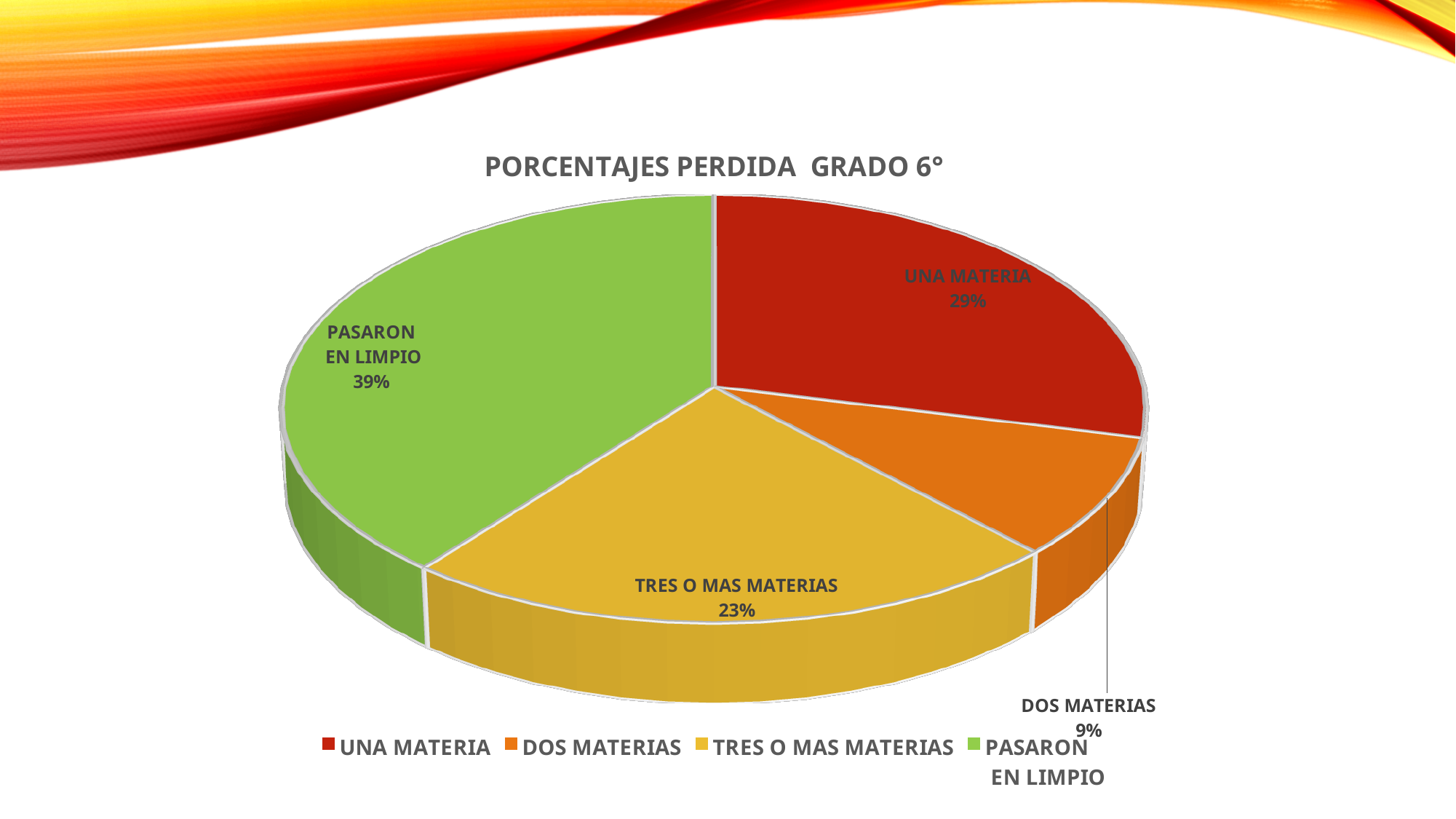
How many categories does the pie chart show? 4 What colour is the slice for PASARON EN LIMPIO? Green Which category has the largest share of the pie? PASARON EN LIMPIO What percentage is shown for PASARON EN LIMPIO? 39% What is the title of the chart? PORCENTAJES PERDIDA GRADO 6° What percentage is shown for UNA MATERIA? 29% What kind of chart is shown on the slide? Pie chart What is the difference in percentage points between PASARON EN LIMPIO and UNA MATERIA? 10 Which is larger, UNA MATERIA or TRES O MAS MATERIAS? UNA MATERIA Which category has the smallest share of the pie? DOS MATERIAS What percentage is shown for DOS MATERIAS? 9% What percentage is shown for TRES O MAS MATERIAS? 23%